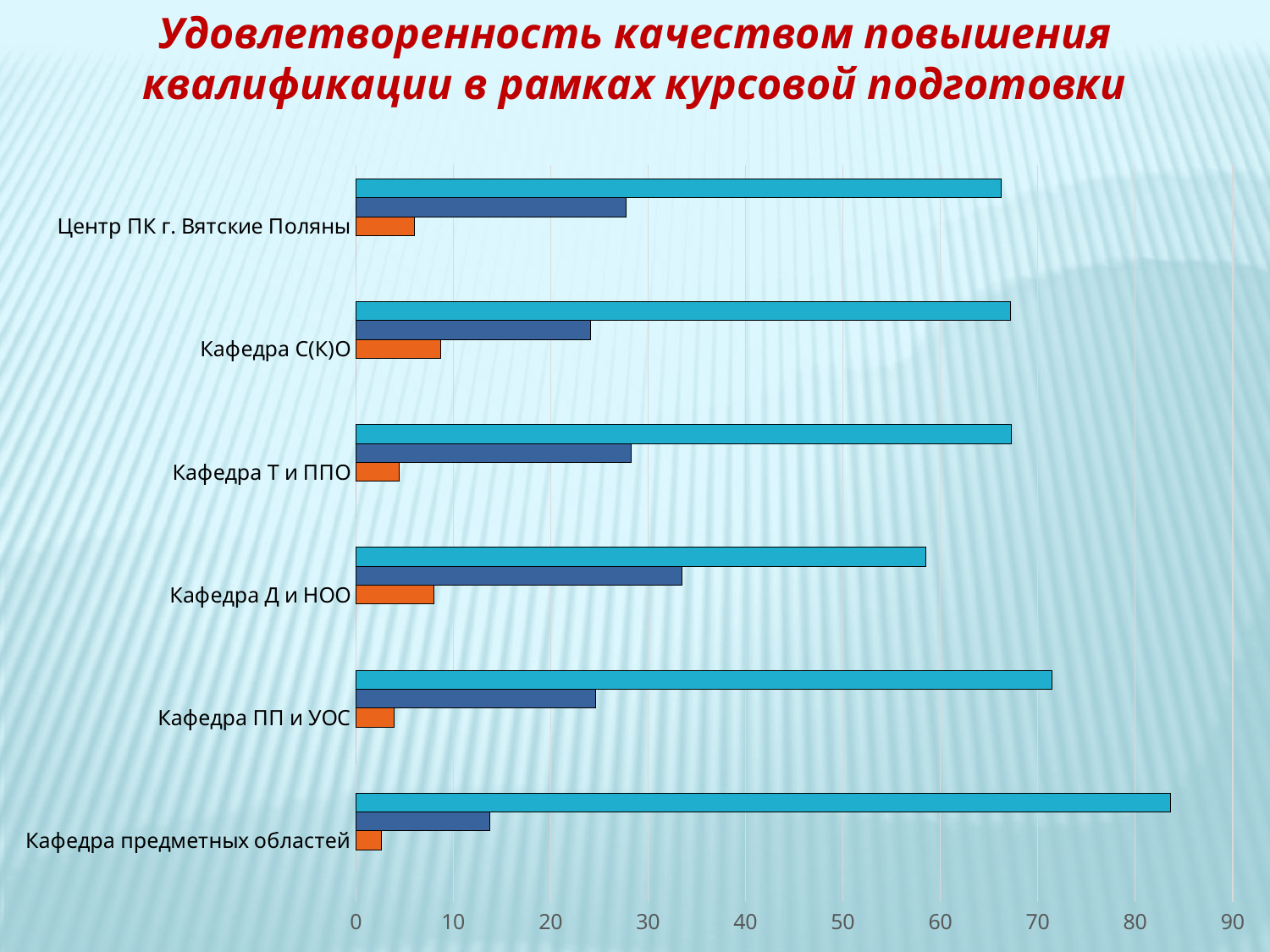
How many bars are plotted for each category? 3 How many categories (departments) are shown on the chart? 6 Is the light-blue bar for Кафедра предметных областей greater or less than 80? greater Is the dark-blue bar for Центр ПК г. Вятские Поляны greater or less than 20? greater What kind of chart is shown on the slide? bar chart Which category has the shortest dark-blue bar? Кафедра предметных областей Which category has the longest light-blue bar? Кафедра предметных областей Is the light-blue bar for Кафедра Д и НОО greater or less than 60? less Which is larger: the dark-blue bar for Кафедра Д и НОО or the dark-blue bar for Кафедра предметных областей? Кафедра Д и НОО Which category has the longest dark-blue bar? Кафедра Д и НОО Which category has the shortest light-blue bar? Кафедра Д и НОО